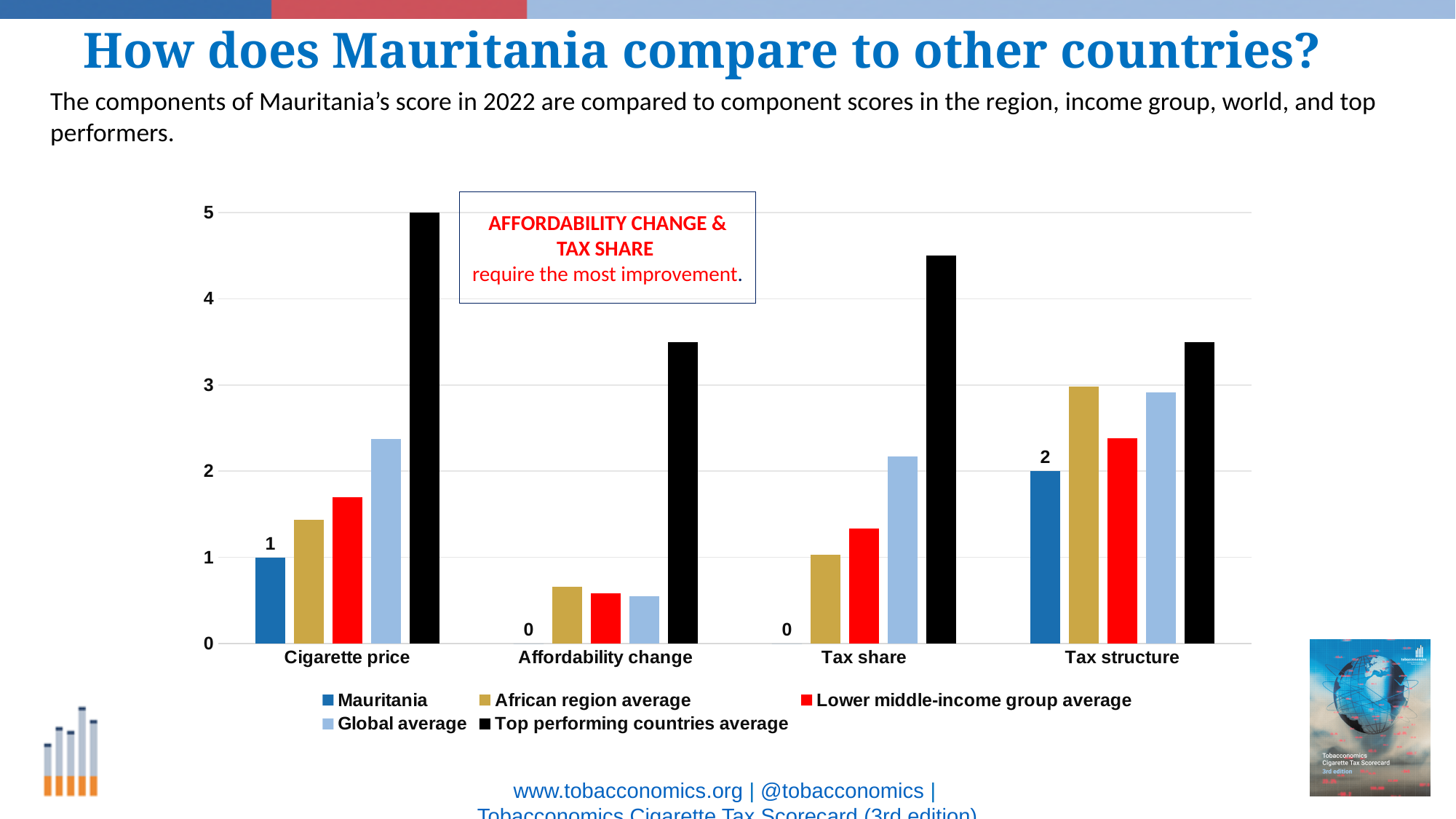
Is the Global average for Cigarette price greater or less than 2? greater What is Mauritania's score for Affordability change? 0 How many series does the legend list? 5 Which series has the highest bar in the Cigarette price group? Top performing countries average What is the difference between Mauritania's Tax structure score and its Cigarette price score? 1 How many component categories are shown on the x axis? 4 Is the Top performing countries average for Tax share greater or less than 4? greater Is the African region average for Affordability change greater or less than 1? less In which component does Mauritania have its highest score? Tax structure What is Mauritania's score for Tax structure? 2 What is Mauritania's score for Cigarette price? 1 What is the Top performing countries average score for Cigarette price? 5